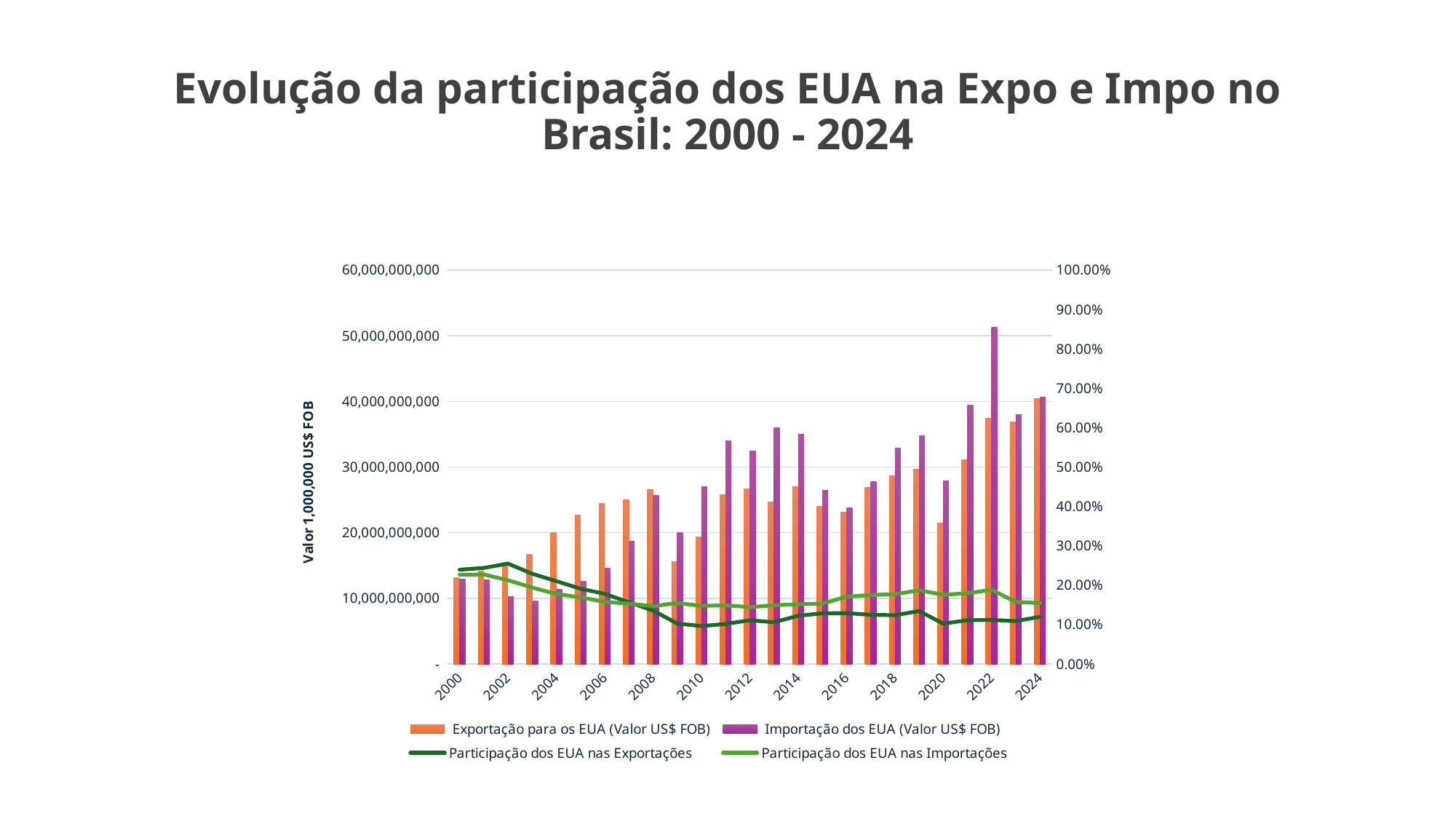
How many years are plotted along the x axis? 25 How many series does the legend list? 4 In which year is the Importação dos EUA (Valor US$ FOB) bar the highest? 2022 What kind of chart is shown on the slide? A combined bar and line chart What is the title of the chart? Evolução da participação dos EUA na Expo e Impo no Brasil: 2000 - 2024 Does the Participação dos EUA nas Exportações line rise or fall between 2002 and 2010? fall In which year is the Exportação para os EUA (Valor US$ FOB) bar the highest? 2024 Is the Importação dos EUA value for 2003 greater or less than 20,000,000,000? less In 2022, which is larger: Exportação para os EUA or Importação dos EUA? Importação dos EUA Is the Exportação para os EUA value for 2000 greater or less than 20,000,000,000? less In 2007, which is larger: Exportação para os EUA or Importação dos EUA? Exportação para os EUA Is the Importação dos EUA value for 2022 greater or less than 40,000,000,000? greater